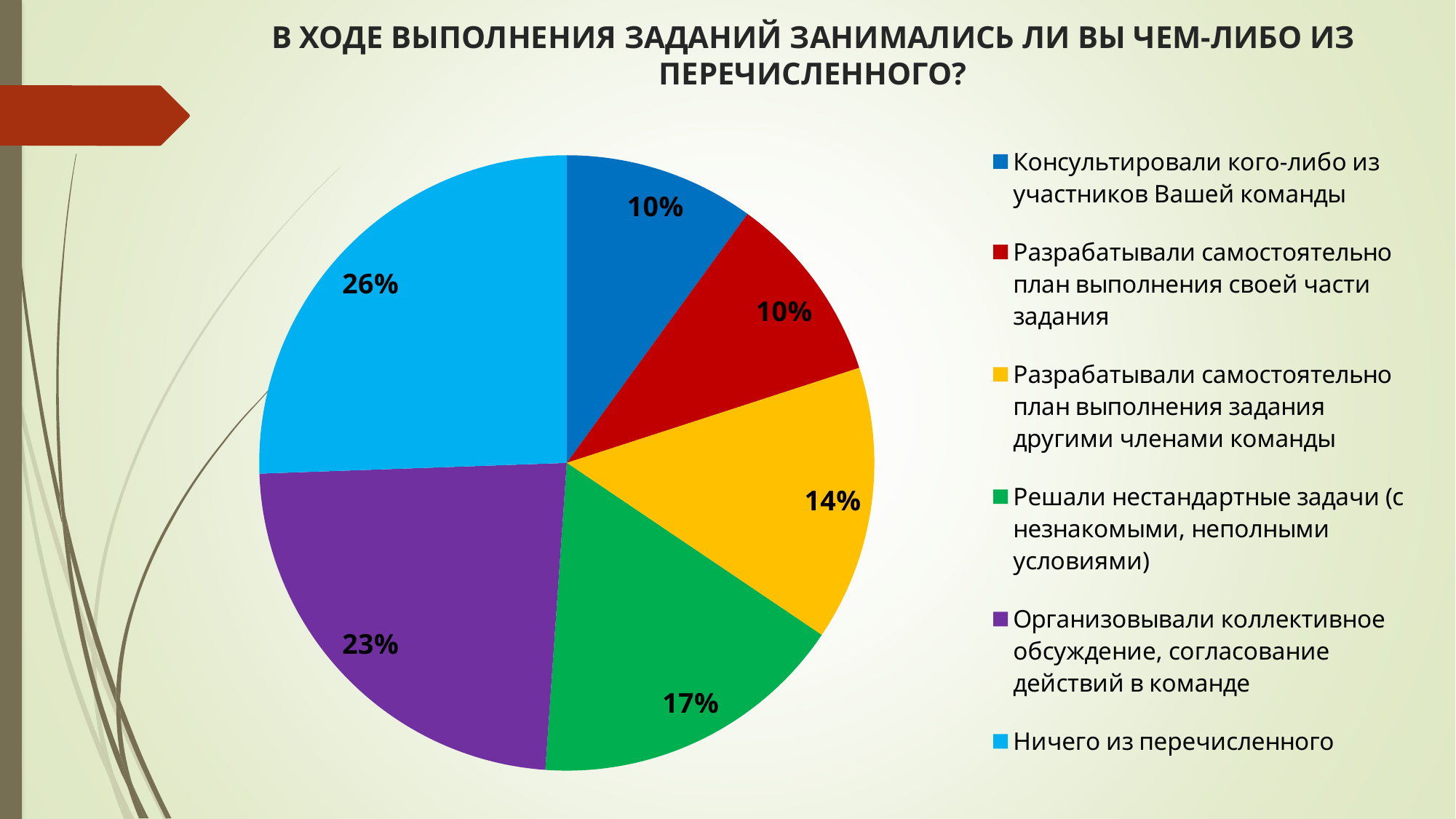
What is the difference in percentage points between "Ничего из перечисленного" and "Организовывали коллективное обсуждение, согласование действий в команде"? 3 What percentage is shown for "Консультировали кого-либо из участников Вашей команды"? 10% What percentage is shown for "Решали нестандартные задачи (с незнакомыми, неполными условиями)"? 17% Which is larger: the share for "Решали нестандартные задачи" or the share for "Разрабатывали самостоятельно план выполнения задания другими членами команды"? Решали нестандартные задачи Which category has the largest share of the pie? Ничего из перечисленного What colour is the slice for "Ничего из перечисленного"? Light blue What percentage is shown for "Разрабатывали самостоятельно план выполнения задания другими членами команды"? 14% What percentage is shown for "Организовывали коллективное обсуждение, согласование действий в команде"? 23% How many slices does the pie chart have? 6 How many entries does the legend list? 6 What share of the pie is labelled "Ничего из перечисленного"? 26% What kind of chart is shown on the slide? Pie chart